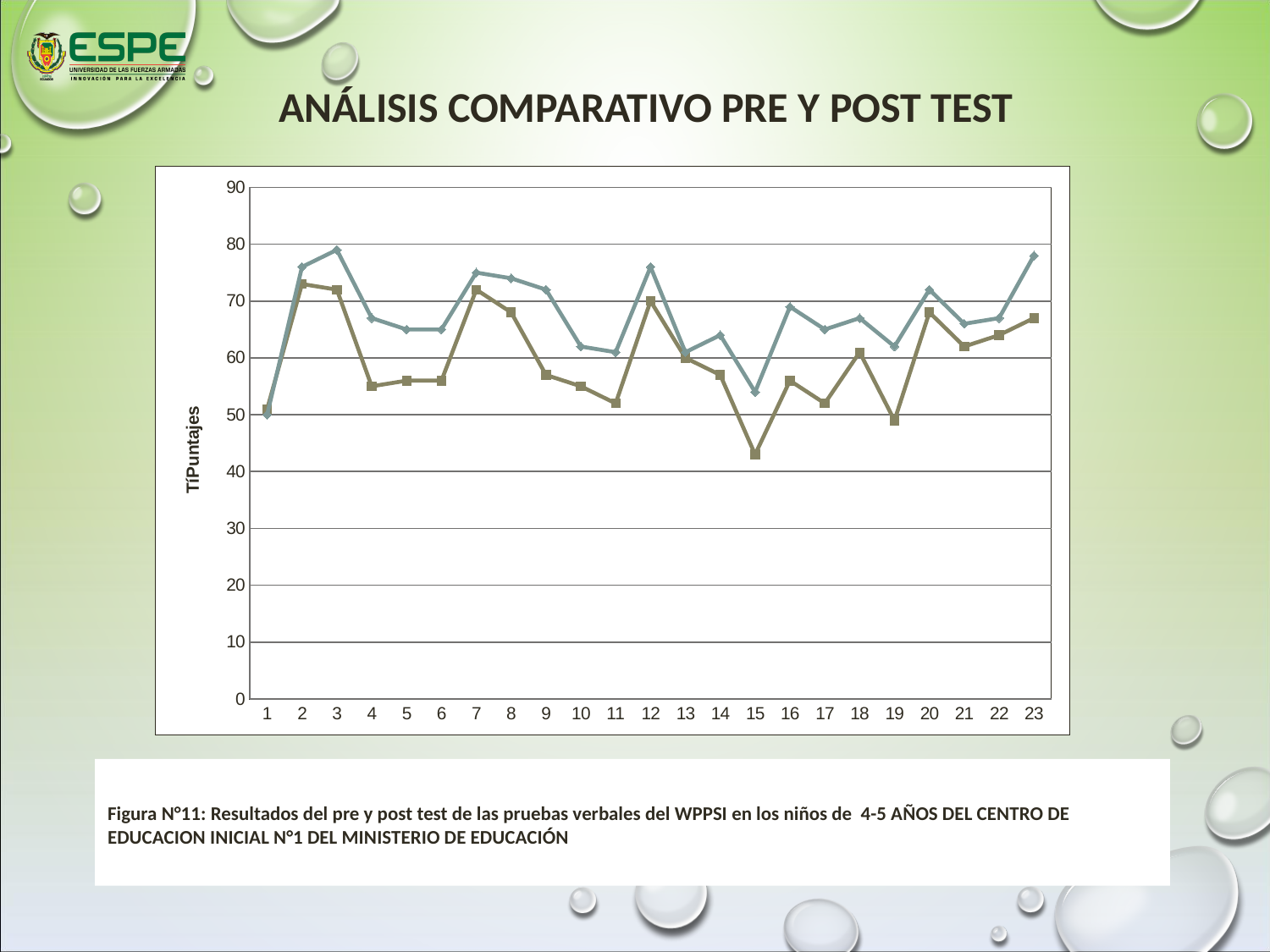
At point 15, which line has the higher value: the blue-grey line with diamond markers or the brown line with square markers? the blue-grey line with diamond markers What is the title of the y axis of the chart? TíPuntajes Does the blue-grey line with diamond markers rise or fall from point 12 to point 15? fall What kind of chart is shown on the slide? line chart How many lines are plotted on the chart? 2 At which x-axis point does the blue-grey line with diamond markers reach its lowest value? 1 Is the value of the brown line with square markers at point 4 greater or less than 60? less Is the value of the blue-grey line with diamond markers at point 3 greater or less than 70? greater What is the title shown above the chart on the slide? ANÁLISIS COMPARATIVO PRE Y POST TEST How many points are labelled along the x axis of the chart? 23 At which x-axis point does the brown line with square markers reach its lowest value? 15 Is the value of the brown line with square markers at point 15 greater or less than 50? less